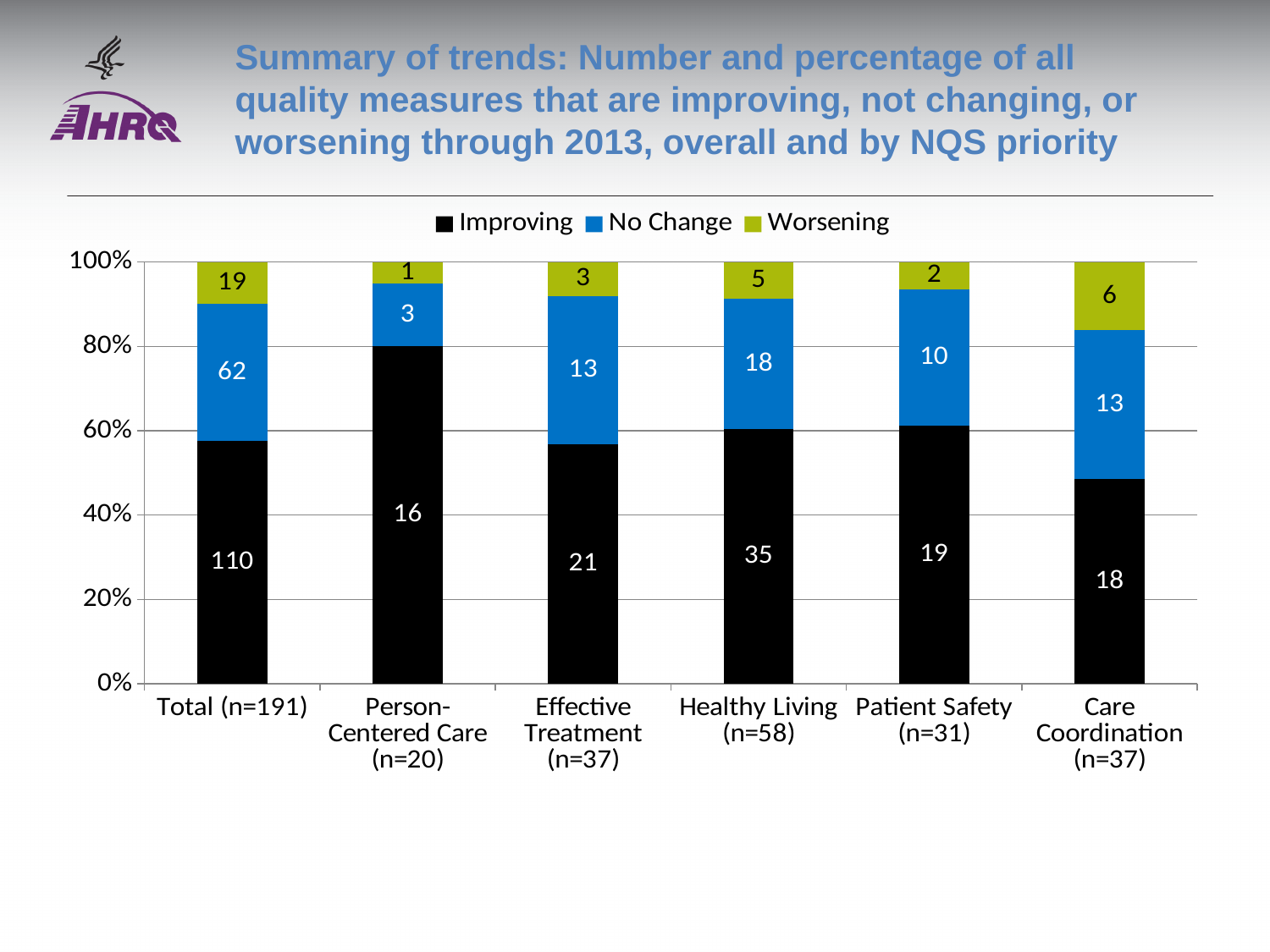
What is the Worsening value for Care Coordination (n=37)? 6 Which category has the lowest Worsening value? Person-Centered Care (n=20) Which is larger: the No Change value for Patient Safety (n=31) or the No Change value for Care Coordination (n=37)? Care Coordination (n=37) What is the Improving value for Patient Safety (n=31)? 19 What type of chart is shown on the slide? Stacked bar chart How many series does the legend list? 3 What is the No Change value for Healthy Living (n=58)? 18 What is the difference between the Improving and No Change values for Effective Treatment (n=37)? 8 Is the Improving share of the Care Coordination (n=37) bar greater or less than 40%? greater Excluding the Total bar, which category has the highest Improving value? Healthy Living (n=58) How many categories are shown on the x axis? 6 How many quality measures are Improving in the Total (n=191) bar? 110